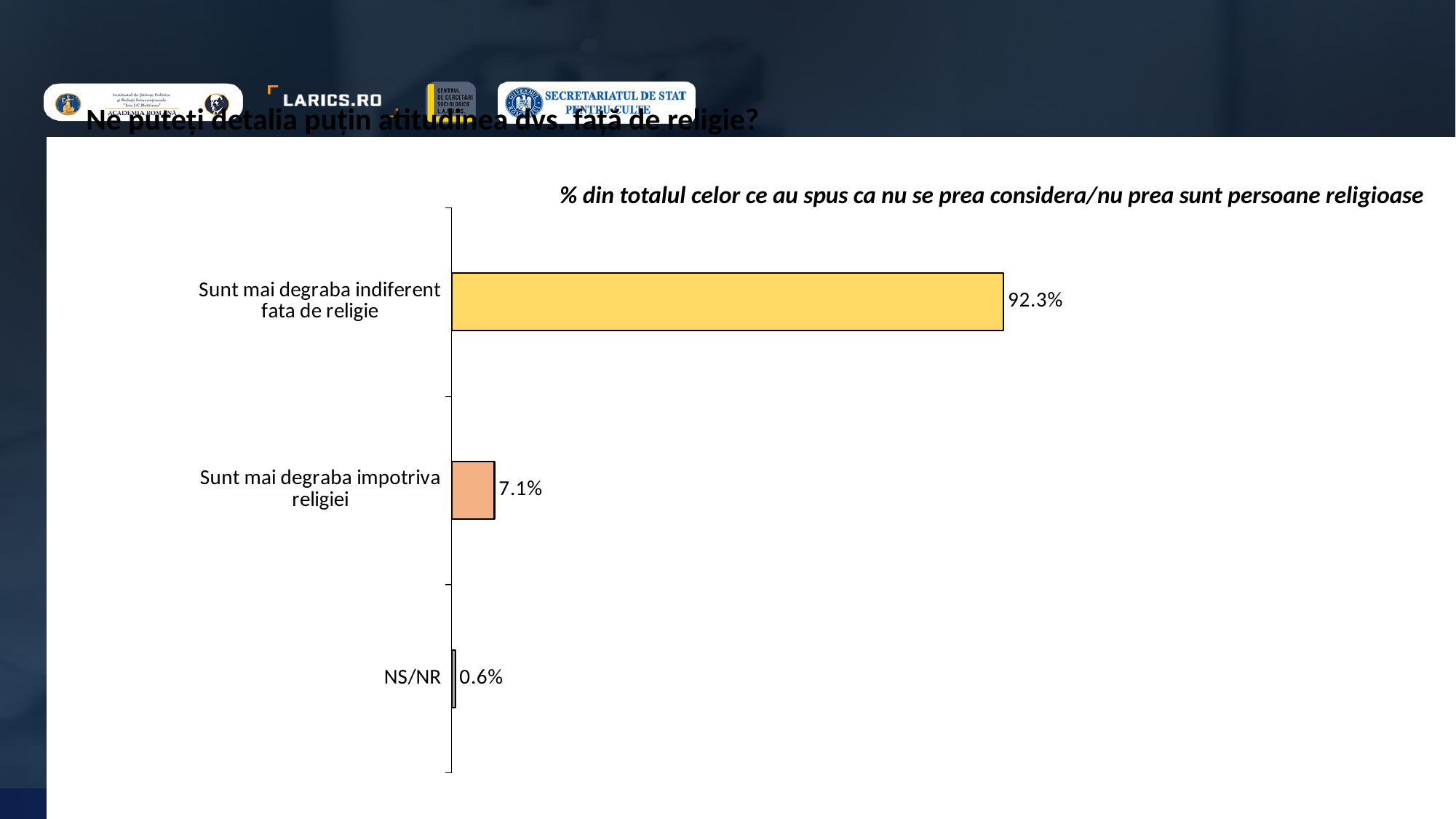
How many categories are shown in the chart? 3 What is the subtitle text shown above the chart? % din totalul celor ce au spus ca nu se prea considera/nu prea sunt persoane religioase What is the value for "Sunt mai degraba impotriva religiei"? 7.1% What is the value for "Sunt mai degraba indiferent fata de religie"? 92.3% What is the value for NS/NR? 0.6% What is the difference between "Sunt mai degraba impotriva religiei" and NS/NR? 6.5% Which is larger: "Sunt mai degraba impotriva religiei" or NS/NR? Sunt mai degraba impotriva religiei What kind of chart is shown on the slide? Bar chart What is the total of the three values shown in the chart? 100% Which category has the highest value? Sunt mai degraba indiferent fata de religie What is the difference between "Sunt mai degraba indiferent fata de religie" and "Sunt mai degraba impotriva religiei"? 85.2% Which category has the lowest value? NS/NR